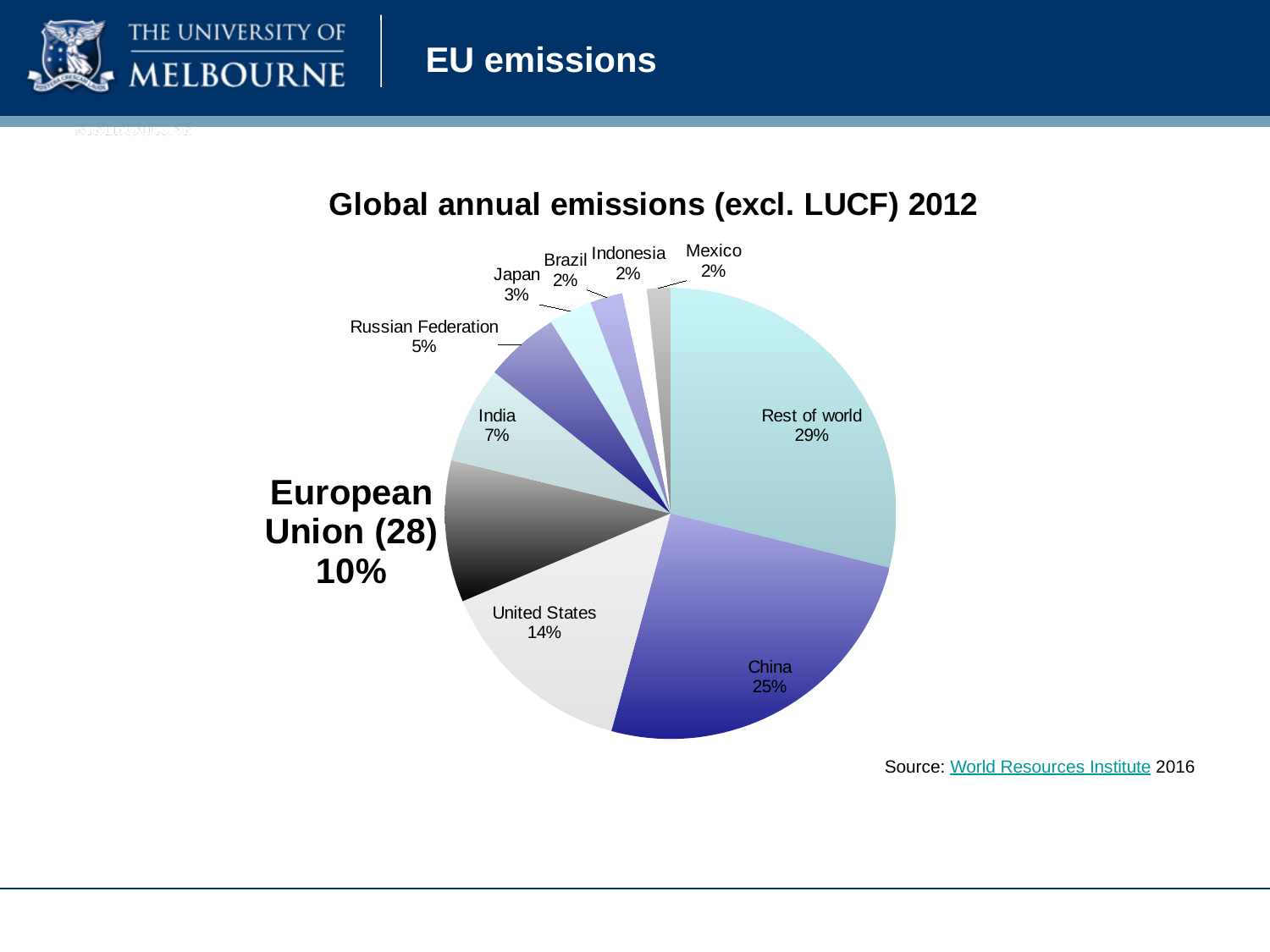
What is the difference in percentage points between Rest of world and the European Union (28)? 19 What is the value shown for Indonesia? 2% Which slice of the pie is the largest? Rest of world What is the title of the chart? Global annual emissions (excl. LUCF) 2012 What share of global annual emissions does China account for? 25% What is the value shown for the United States? 14% What share of global annual emissions does the European Union (28) account for? 10% What is the value shown for the Russian Federation? 5% What type of chart is shown on the slide? Pie chart What is the difference in percentage points between China and the United States? 11 How many slices does the pie chart have? 10 Which has the larger share, India or Japan? India